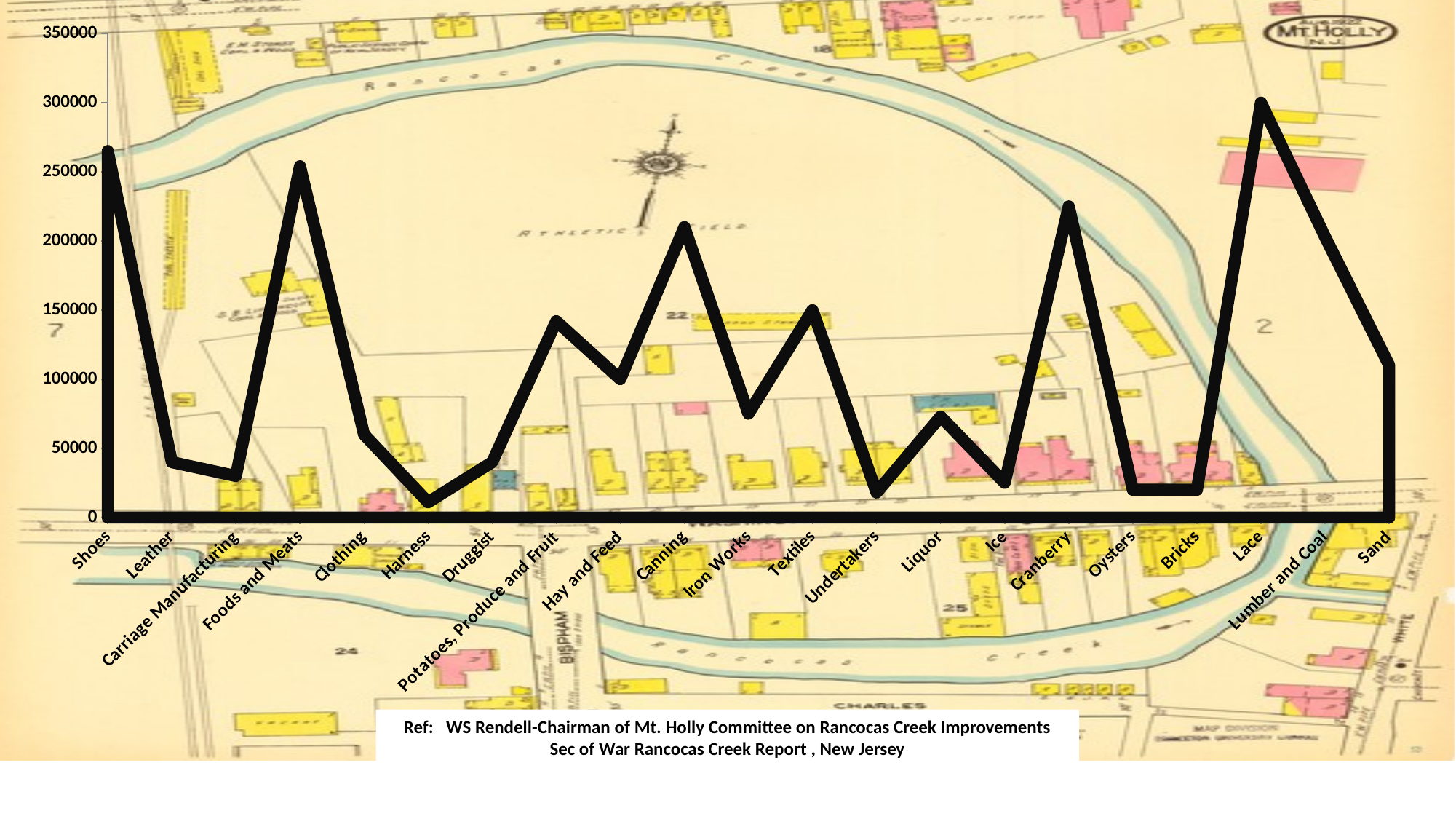
Is the value for Canning greater or less than 150000? greater Is the value for Harness greater or less than 50000? less Which category has the highest value? Lace What kind of chart is shown on the slide? line chart What is the highest tick value shown on the y axis? 350000 Is the value for Undertakers greater or less than 50000? less How many categories are plotted along the x axis? 21 Which is larger, the value for Canning or the value for Iron Works? Canning Which is larger, the value for Lace or the value for Cranberry? Lace